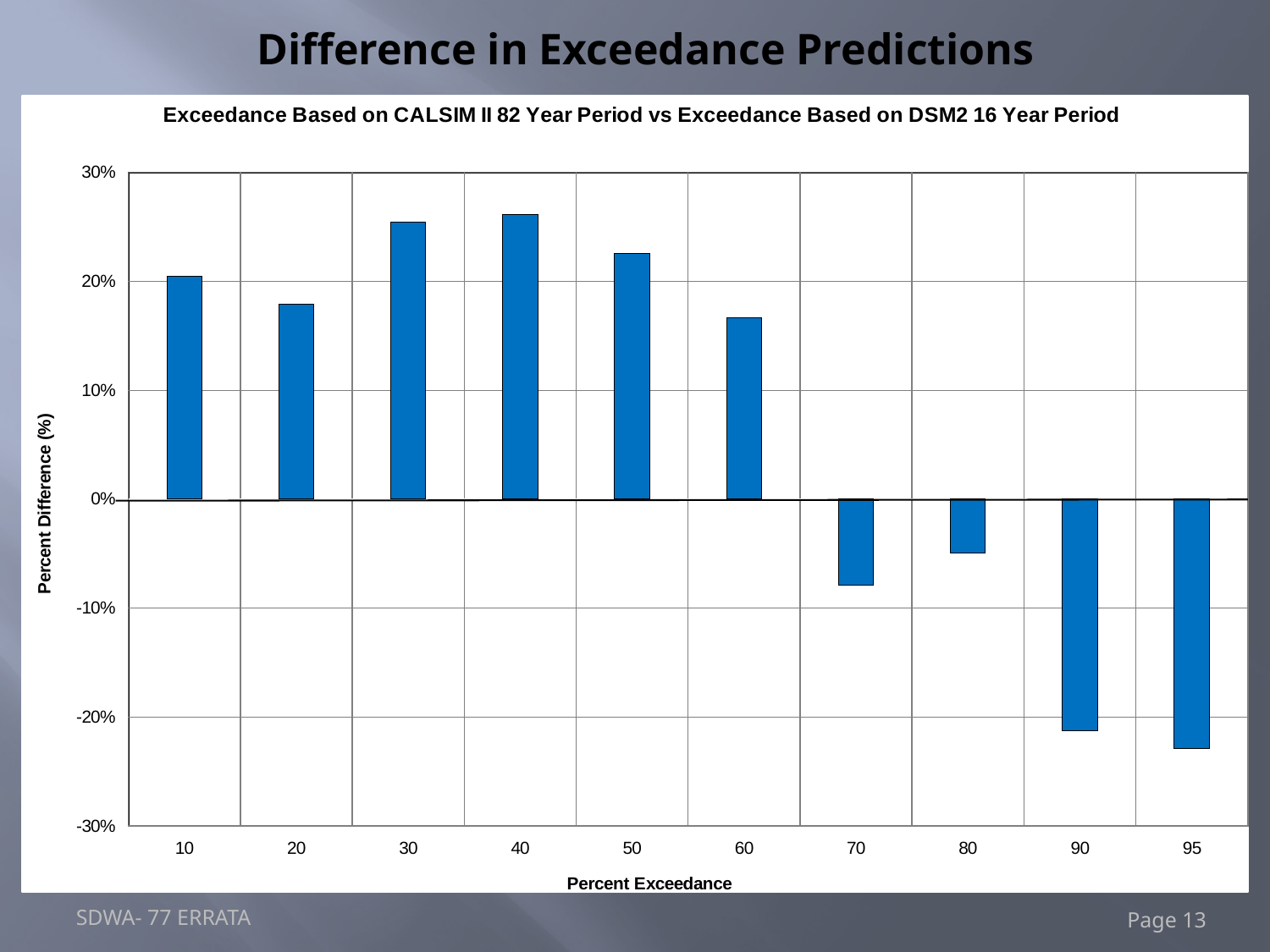
Which has the larger percent difference, 50 percent exceedance or 60 percent exceedance? 50 Which percent exceedance category has the lowest percent difference? 95 Which has the larger percent difference, 80 percent exceedance or 90 percent exceedance? 80 Is the percent difference at 60 percent exceedance greater or less than 20%? less What kind of chart is shown on the slide? bar chart Is the percent difference at 80 percent exceedance greater or less than -10%? greater Do the percent difference values rise or fall along the x axis from 40 to 95 percent exceedance? fall How many percent exceedance categories are plotted on the x axis? 10 Is the percent difference at 90 percent exceedance greater or less than -20%? less What is the title of the y axis? Percent Difference (%)